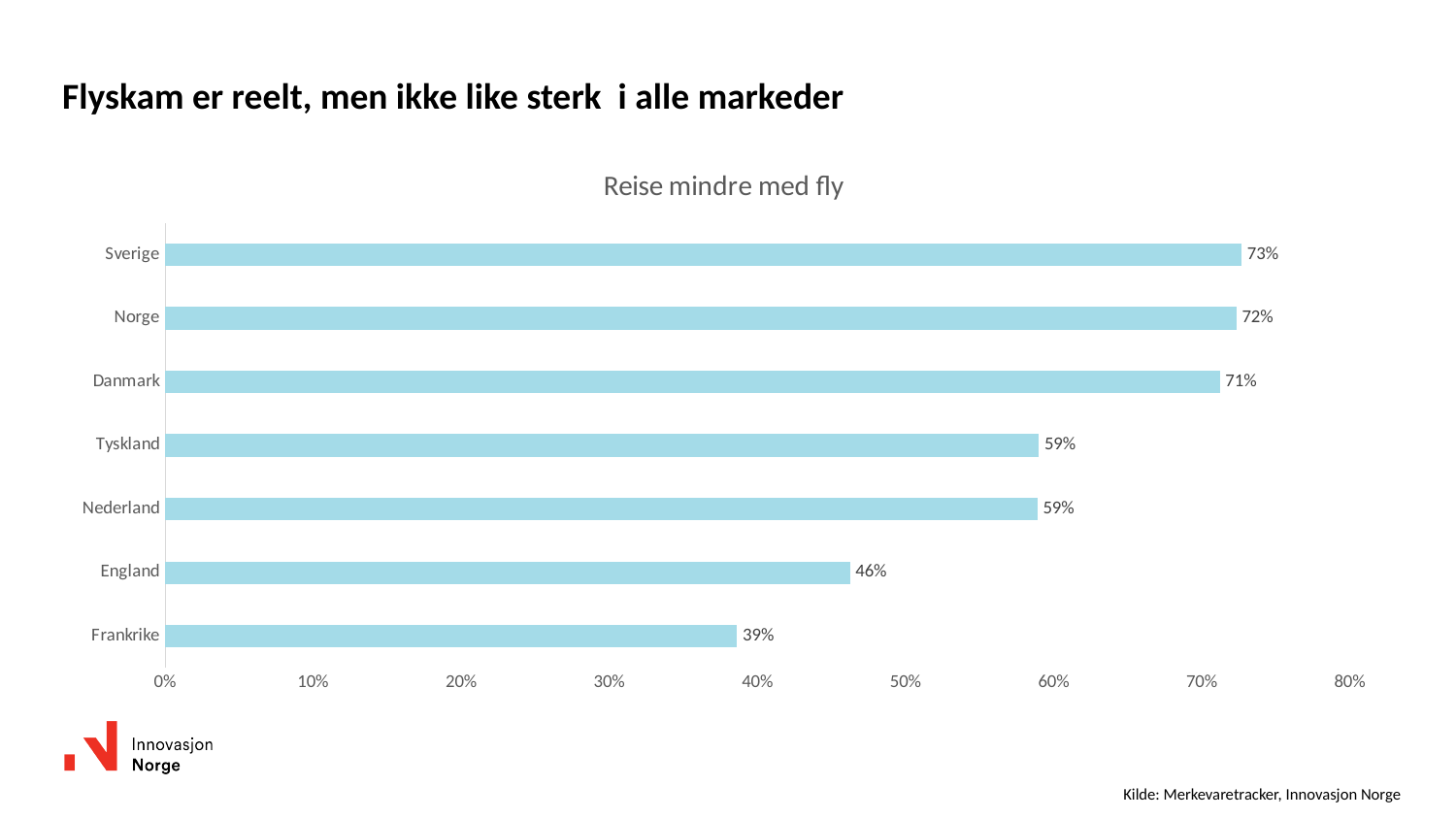
What is the difference between the values for Norge and England? 26% Which country has the lowest value? Frankrike How many countries are shown in the chart? 7 What is the value for Sverige? 73% What kind of chart is shown on the slide? Bar chart Which country has the highest value? Sverige What is the value for Tyskland? 59% What is the title of the chart? Reise mindre med fly Which is larger, the value for Danmark or the value for Nederland? Danmark What is the value for Frankrike? 39% What is the difference between the values for Sverige and Frankrike? 34% What is the value for England? 46%